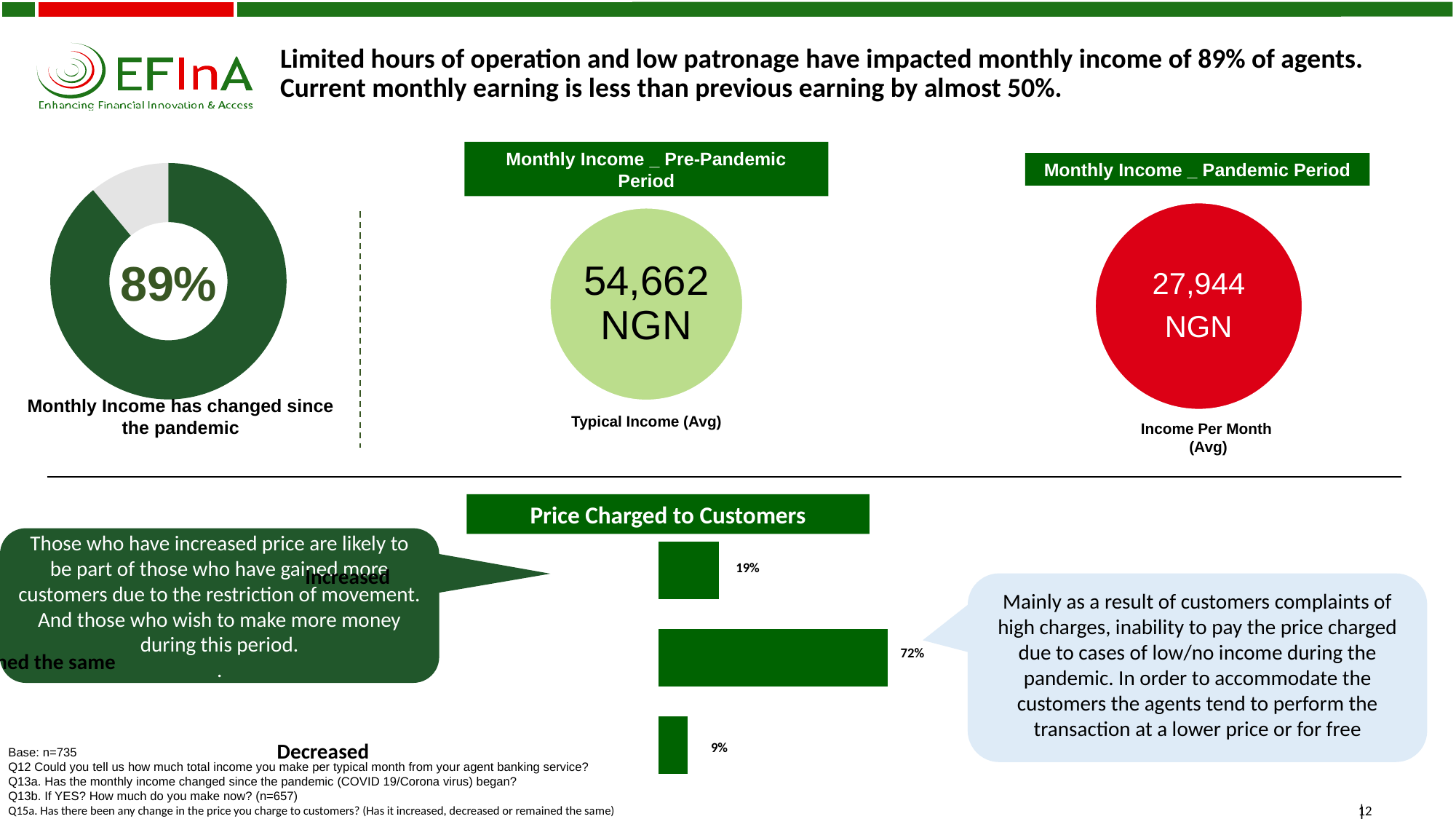
What is the average typical monthly income shown for the pre-pandemic period? 54,662 NGN What kind of chart is used on the left of the slide to show the 89% figure? Donut (pie) chart In the 'Price Charged to Customers' chart, what percentage of agents increased their price? 19% What is the average income per month shown for the pandemic period? 27,944 NGN In the 'Price Charged to Customers' chart, which category has the lowest value? Decreased In the donut chart on the left, what percentage of agents say their monthly income has changed since the pandemic? 89% In the 'Price Charged to Customers' chart, what percentage of agents decreased their price? 9% By how much is the pre-pandemic average monthly income (54,662 NGN) higher than the pandemic-period average (27,944 NGN)? 26,718 NGN In the 'Price Charged to Customers' chart, what is the difference between the Increased and Decreased percentages? 10 percentage points In the 'Price Charged to Customers' chart, which is larger: Increased or Decreased? Increased How many bars are shown in the 'Price Charged to Customers' chart? 3 In the 'Price Charged to Customers' chart, what is the value of the middle bar (price remained the same)? 72%